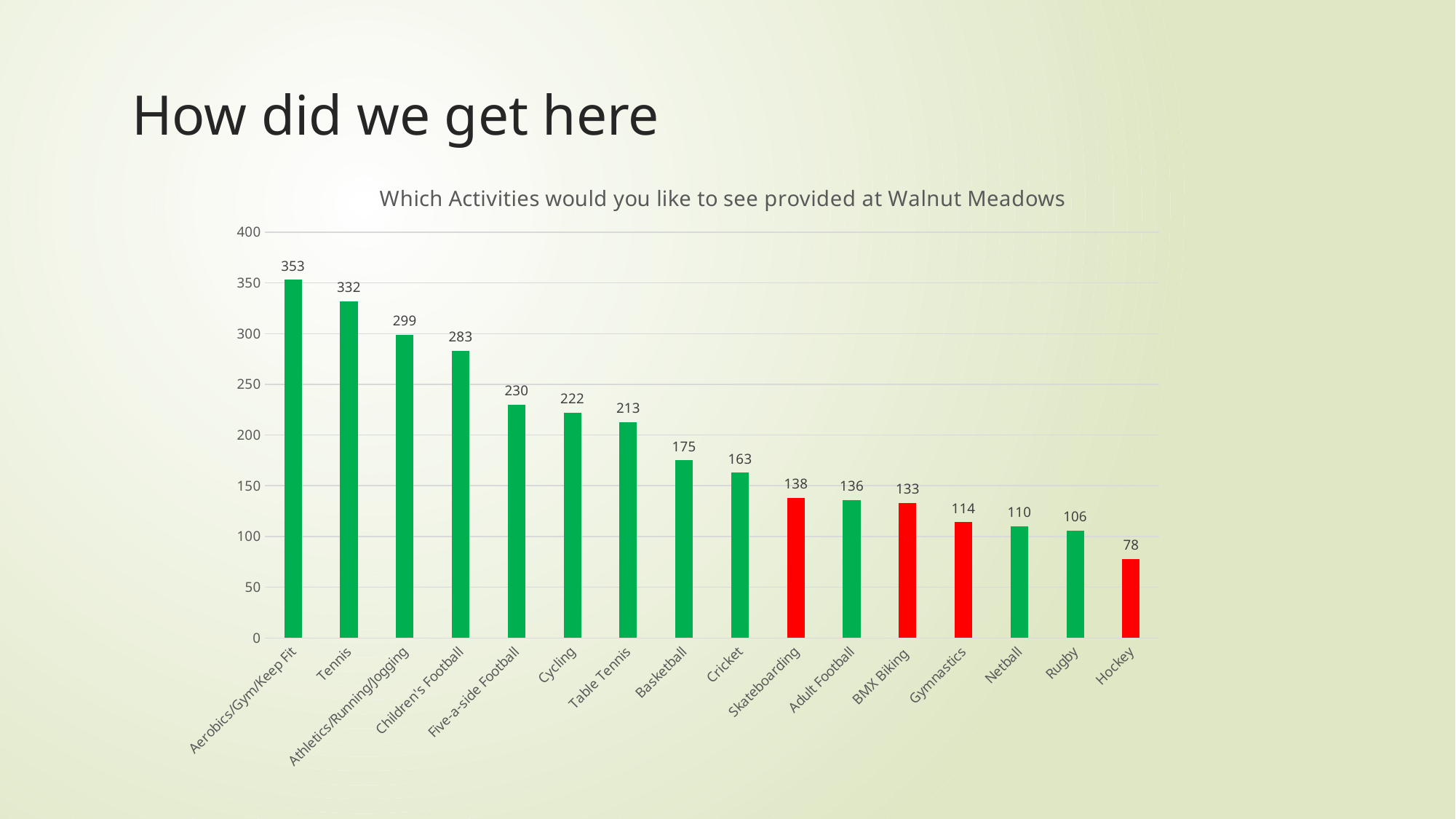
How many activities are shown on the chart? 16 What is the difference between the values for Netball and Hockey? 32 Which activity has the lowest value? Hockey Which activity has the highest value? Aerobics/Gym/Keep Fit What is the title of the chart? Which Activities would you like to see provided at Walnut Meadows What is the value for Cricket? 163 What is the value for Tennis? 332 Is the value for Five-a-side Football greater or less than 200? greater What is the difference between the values for Tennis and Children's Football? 49 Which is larger, the value for Cycling or the value for Basketball? Cycling What is the value for Gymnastics? 114 What kind of chart is shown on the slide? Bar chart